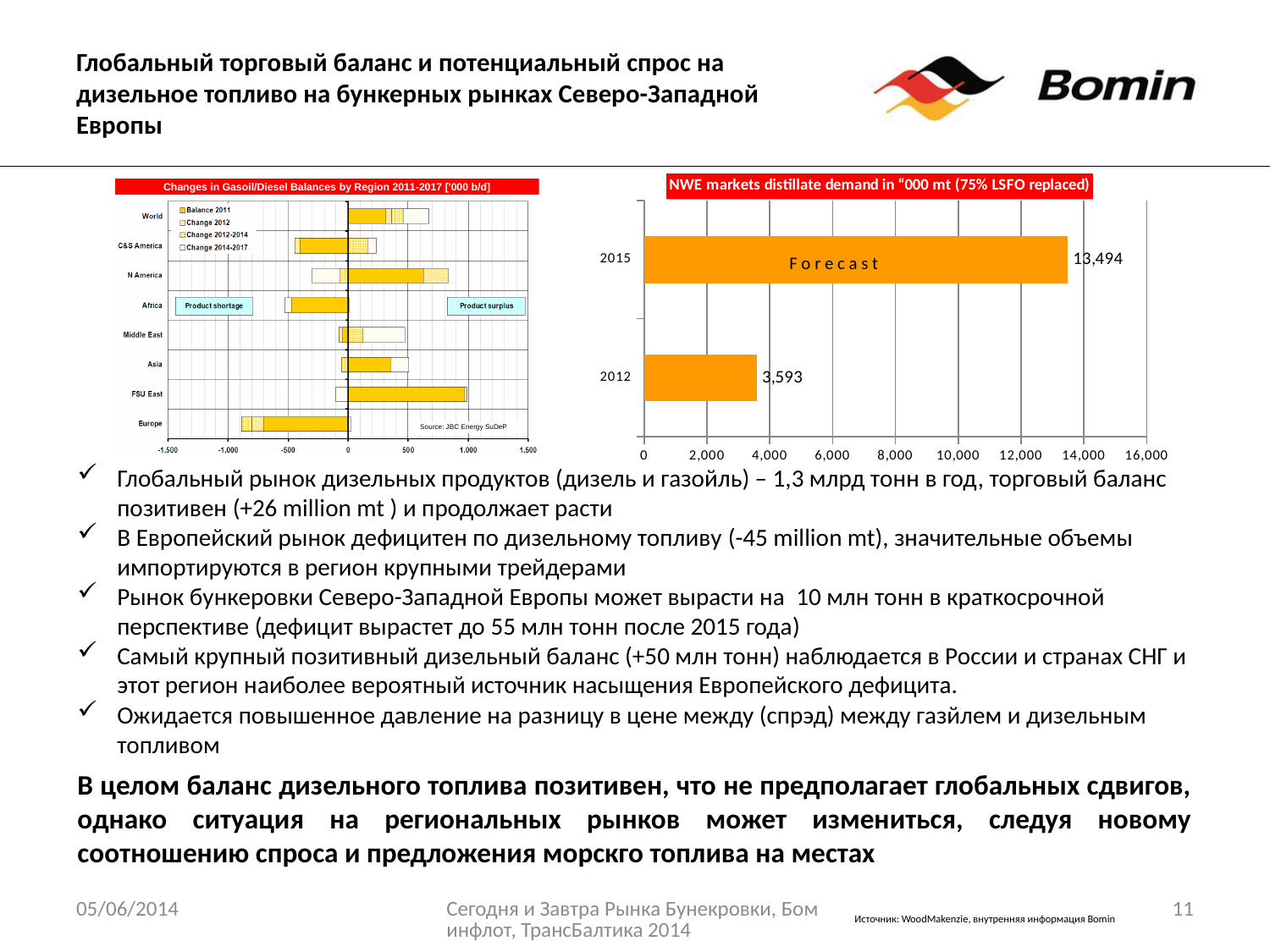
In the chart titled "NWE markets distillate demand in "000 mt (75% LSFO replaced)", what is the value for 2015? 13,494 In the chart titled "Changes in Gasoil/Diesel Balances by Region 2011-2017" on the left, is the Balance 2011 value for FSU East greater or less than 500? greater In the NWE markets distillate demand chart on the right, how many bars are plotted? 2 In the chart titled "Changes in Gasoil/Diesel Balances by Region 2011-2017" on the left, how many regions are listed on the vertical axis? 8 What kind of chart is the NWE markets distillate demand chart on the right? bar chart In the chart titled "NWE markets distillate demand in "000 mt (75% LSFO replaced)", what is the value for 2012? 3,593 In the chart titled "Changes in Gasoil/Diesel Balances by Region 2011-2017" on the left, how many series does the legend list? 4 In the NWE markets distillate demand chart on the right, which year has the higher value? 2015 In the NWE markets distillate demand chart on the right, does the value rise or fall from 2012 to 2015? rise In the chart titled "Changes in Gasoil/Diesel Balances by Region 2011-2017" on the left, is the Balance 2011 value for Europe greater or less than 0? less In the NWE markets distillate demand chart on the right, what word is written inside the 2015 bar? Forecast In the NWE markets distillate demand chart on the right, what is the difference between the 2015 and 2012 values? 9,901